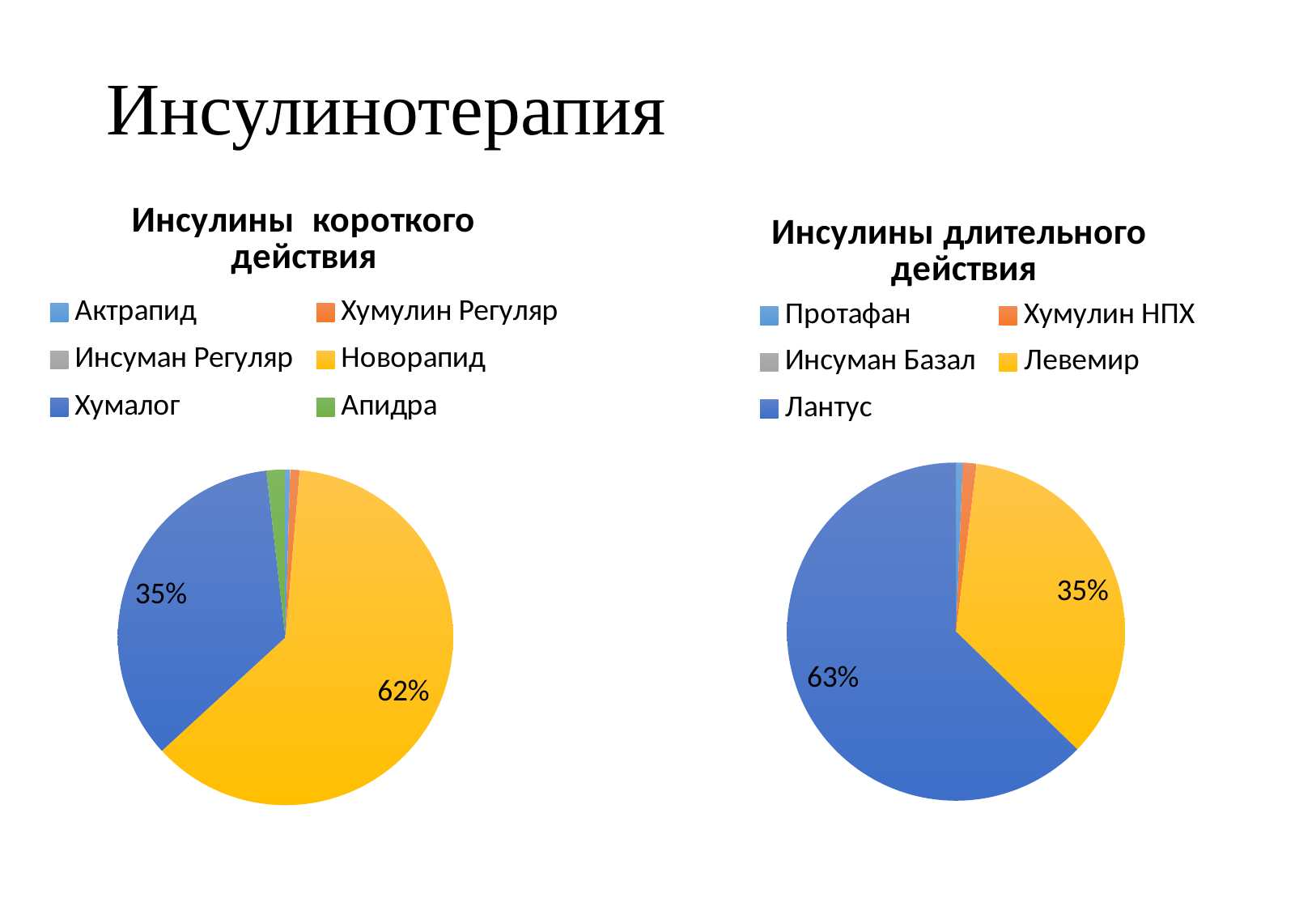
In the chart titled "Инсулины длительного действия", which category has the largest slice? Лантус In the chart titled "Инсулины длительного действия", what share does Левемир have? 35% In the chart titled "Инсулины короткого действия", what is the difference between the shares of Новорапид and Хумалог? 27% In the chart titled "Инсулины длительного действия", what is the difference between the shares of Лантус and Левемир? 28% In the chart titled "Инсулины длительного действия", what share does Лантус have? 63% In the chart titled "Инсулины короткого действия", what share does Хумалог have? 35% In the chart titled "Инсулины длительного действия", which is larger: Лантус or Левемир? Лантус How many categories does the legend of the chart titled "Инсулины длительного действия" list? 5 In the chart titled "Инсулины короткого действия", which category has the largest slice? Новорапид How many categories does the legend of the chart titled "Инсулины короткого действия" list? 6 In the chart titled "Инсулины короткого действия", what share does Новорапид have? 62% What type of chart is the chart on the left of the slide? Pie chart